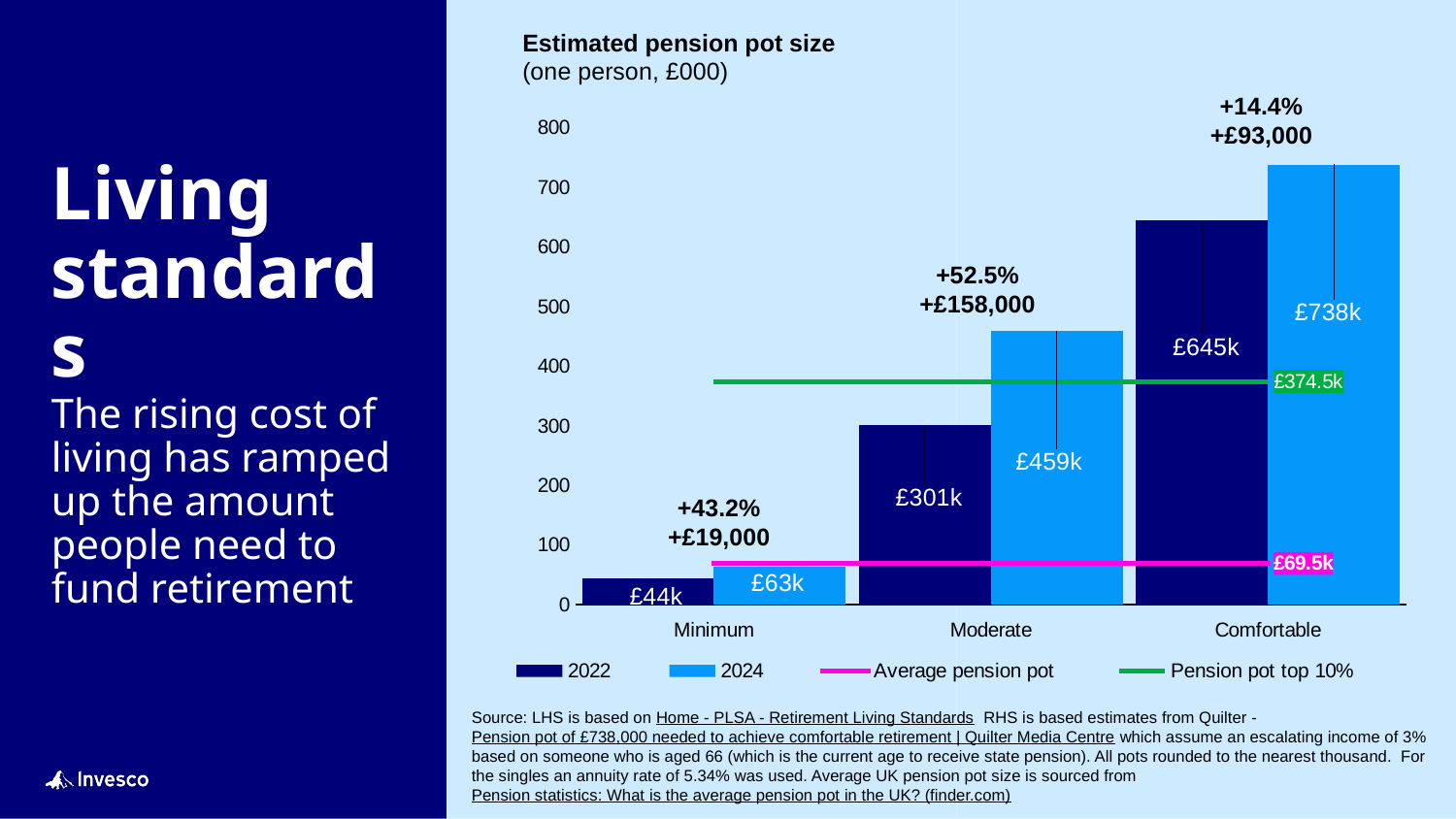
What is the 2024 estimated pension pot size for the Moderate living standard? £459k How many living standard categories are shown on the x axis? 3 Which living standard has the lowest 2022 estimated pension pot size? Minimum What value is shown for the Pension pot top 10% line? £374.5k What value is shown for the Average pension pot line? £69.5k How many series does the legend list? 4 Which living standard has the highest 2024 estimated pension pot size? Comfortable What is the difference between the 2024 and 2022 pension pot sizes for the Moderate living standard? £158k What is the 2022 estimated pension pot size for the Comfortable living standard? £645k What percentage increase is annotated above the Comfortable bars? +14.4% What is the 2022 estimated pension pot size for the Minimum living standard? £44k Which is larger: the 2024 pension pot size for Minimum or the Average pension pot line value? Average pension pot